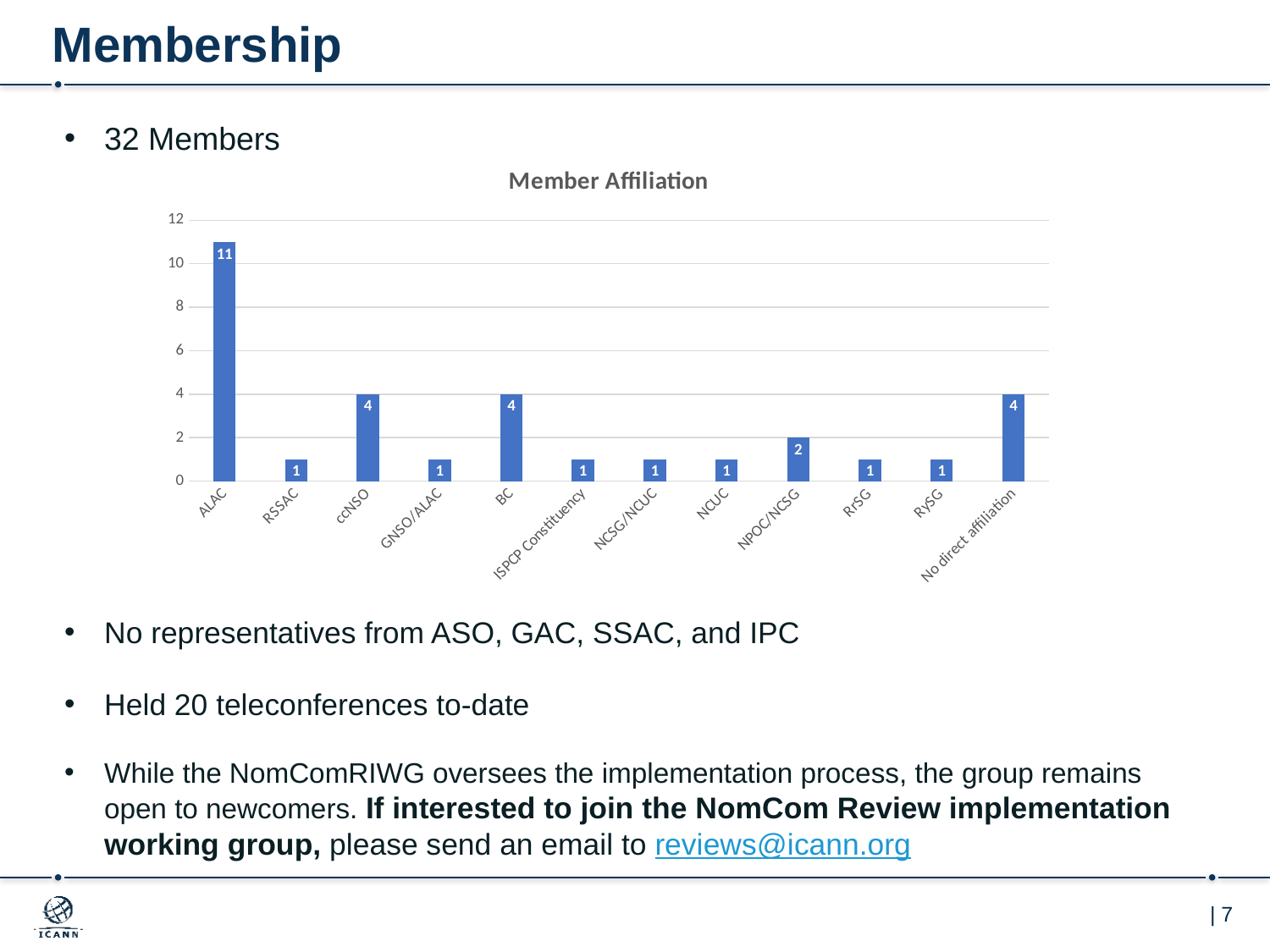
How many categories are shown on the x axis of the Member Affiliation chart? 12 What is the value for ALAC in the Member Affiliation chart? 11 What is the value for RySG in the Member Affiliation chart? 1 What is the difference between the values for NPOC/NCSG and RrSG? 1 Which is larger, the value for BC or the value for NPOC/NCSG? BC What is the value for NPOC/NCSG in the Member Affiliation chart? 2 What is the difference between the values for ALAC and ccNSO? 7 What kind of chart is the Member Affiliation chart? bar chart What is the value for No direct affiliation in the Member Affiliation chart? 4 What is the title of the chart? Member Affiliation Which category has the highest value in the Member Affiliation chart? ALAC Is the value for ALAC greater or less than 10? greater